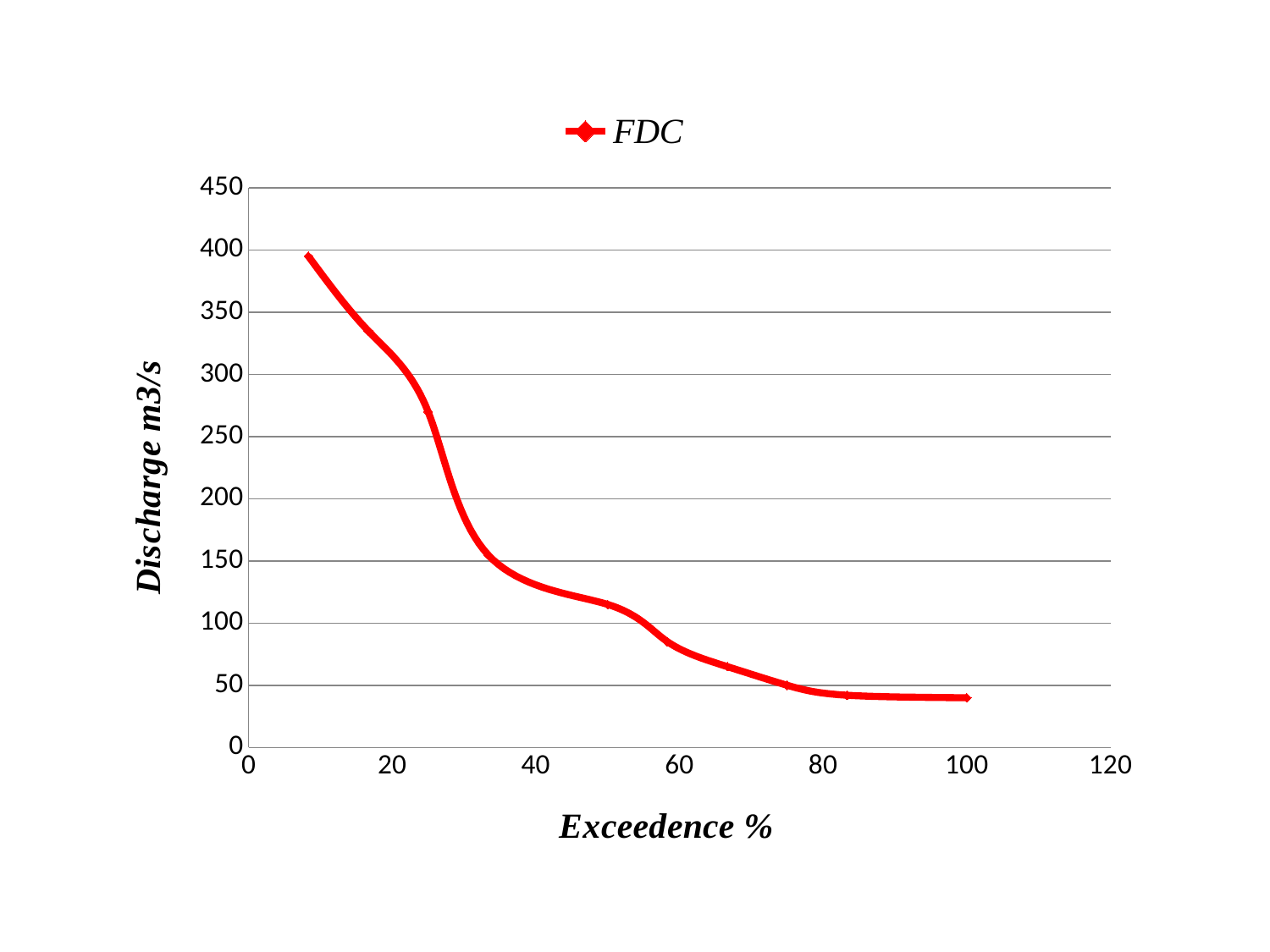
Is the discharge value at 40% exceedence greater or less than 200? less What is the title of the vertical axis? Discharge m3/s How many series does the legend list? 1 Is the discharge value at 25% exceedence greater or less than 250? greater Is the discharge at 20% exceedence larger or smaller than the discharge at 80% exceedence? larger Is the discharge value at 100% exceedence greater or less than 50? less What kind of chart is shown on the slide? line chart Does the discharge rise or fall as Exceedence % increases along the x axis? fall What is the name of the series shown in the legend? FDC